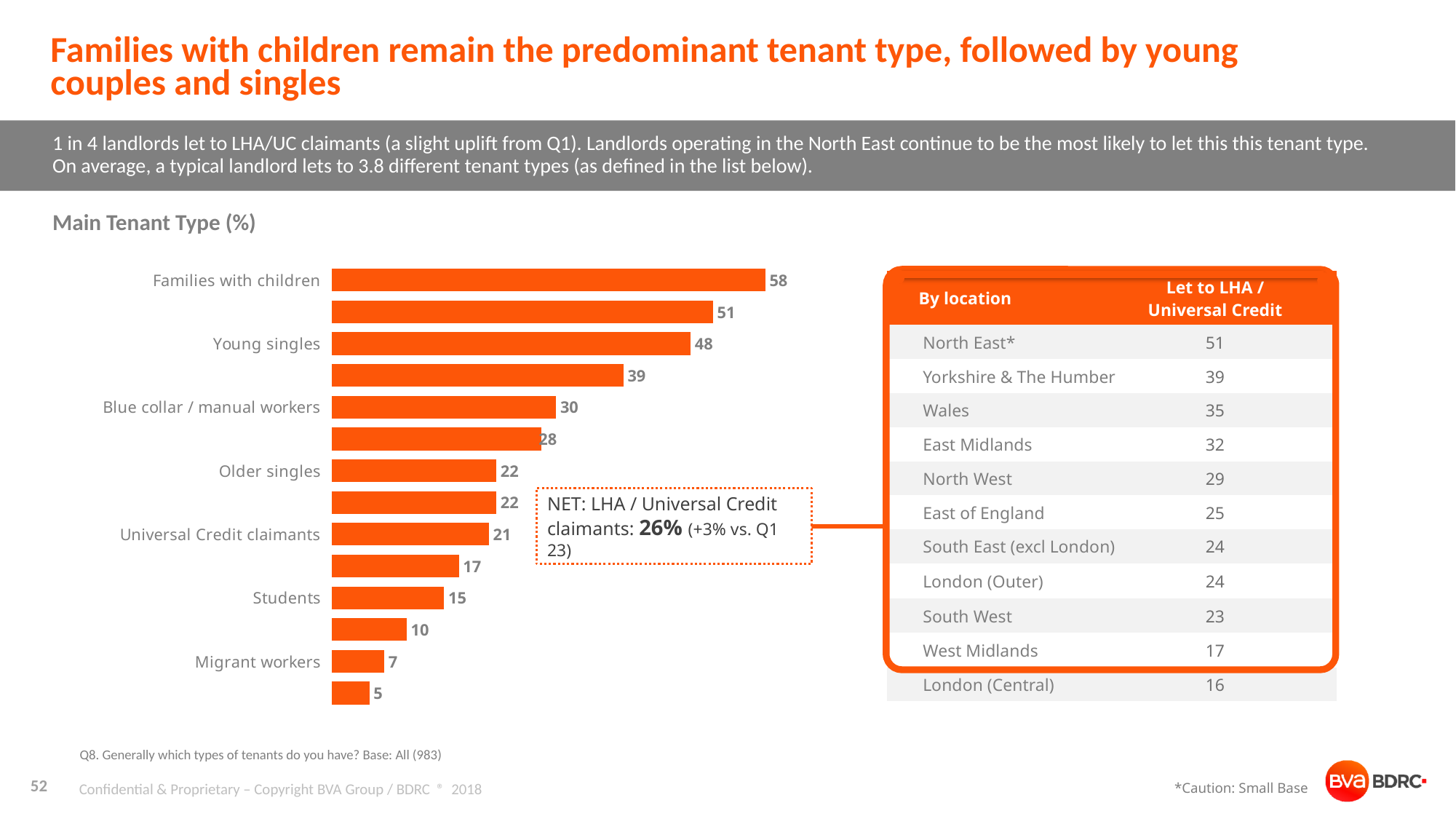
What is the value for Families with children in the Main Tenant Type chart? 58 Which is larger in the Main Tenant Type chart, Students or Older singles? Older singles What is the value of the shortest bar in the Main Tenant Type chart? 5 What is the value for Blue collar / manual workers in the Main Tenant Type chart? 30 What NET percentage of landlords let to LHA / Universal Credit claimants according to the callout on the chart? 26% What type of chart is used to show Main Tenant Type (%)? bar chart How many bars are plotted in the Main Tenant Type chart? 14 What is the difference between the values for Families with children and Young singles in the Main Tenant Type chart? 10 What is the value for Migrant workers in the Main Tenant Type chart? 7 Which tenant type has the highest value in the Main Tenant Type chart? Families with children What is the value for Young singles in the Main Tenant Type chart? 48 What is the value for Universal Credit claimants in the Main Tenant Type chart? 21